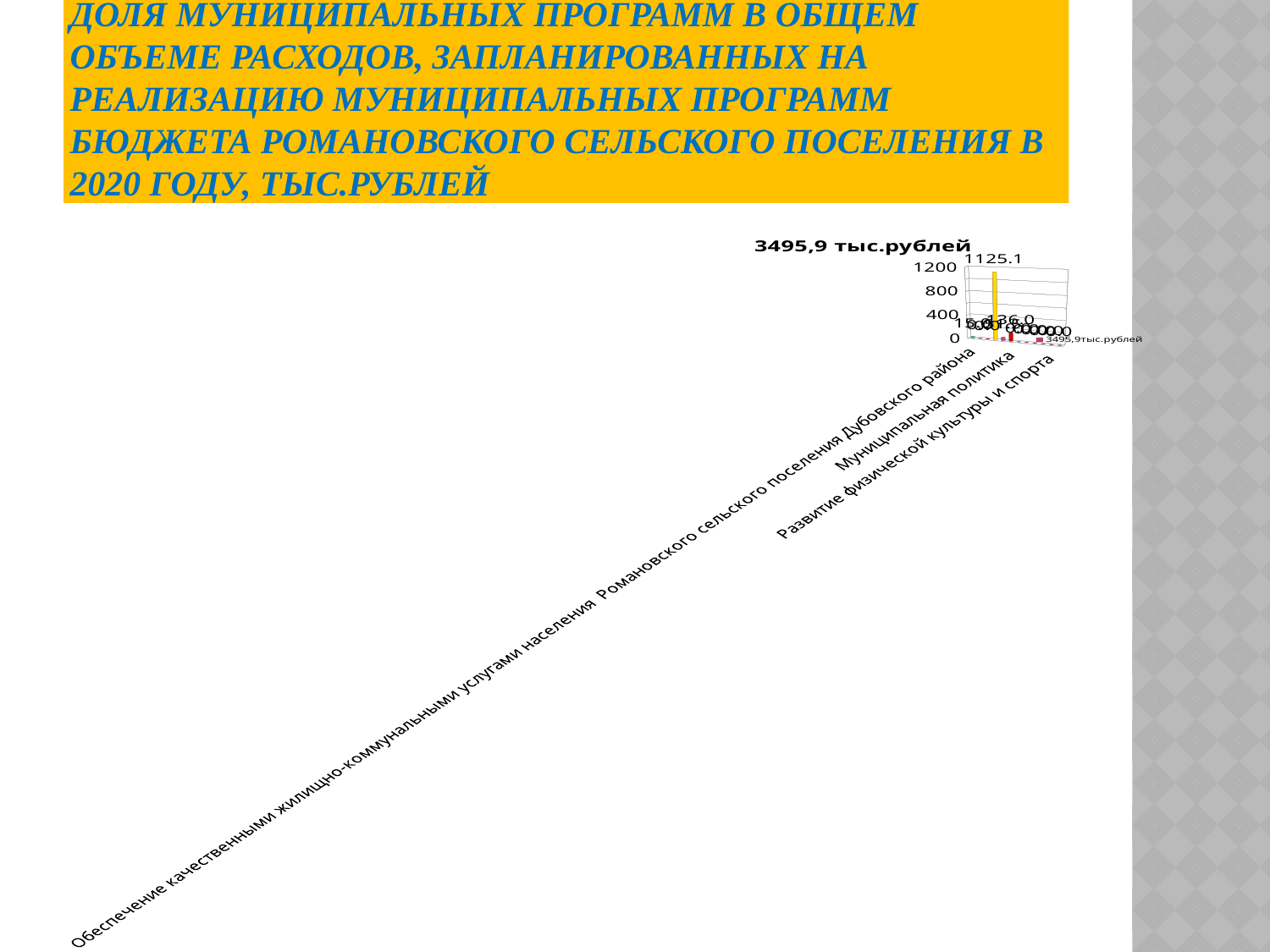
What is the highest data label printed on the chart? 1125.1 What is the title of the chart? 3495,9 тыс.рублей Is the value of the tallest bar greater or less than 800? greater What is the highest tick value shown on the vertical axis? 1200 Is the value of the tallest bar greater or less than 1200? less How many series does the legend list? 1 What kind of chart is shown on the slide? bar chart